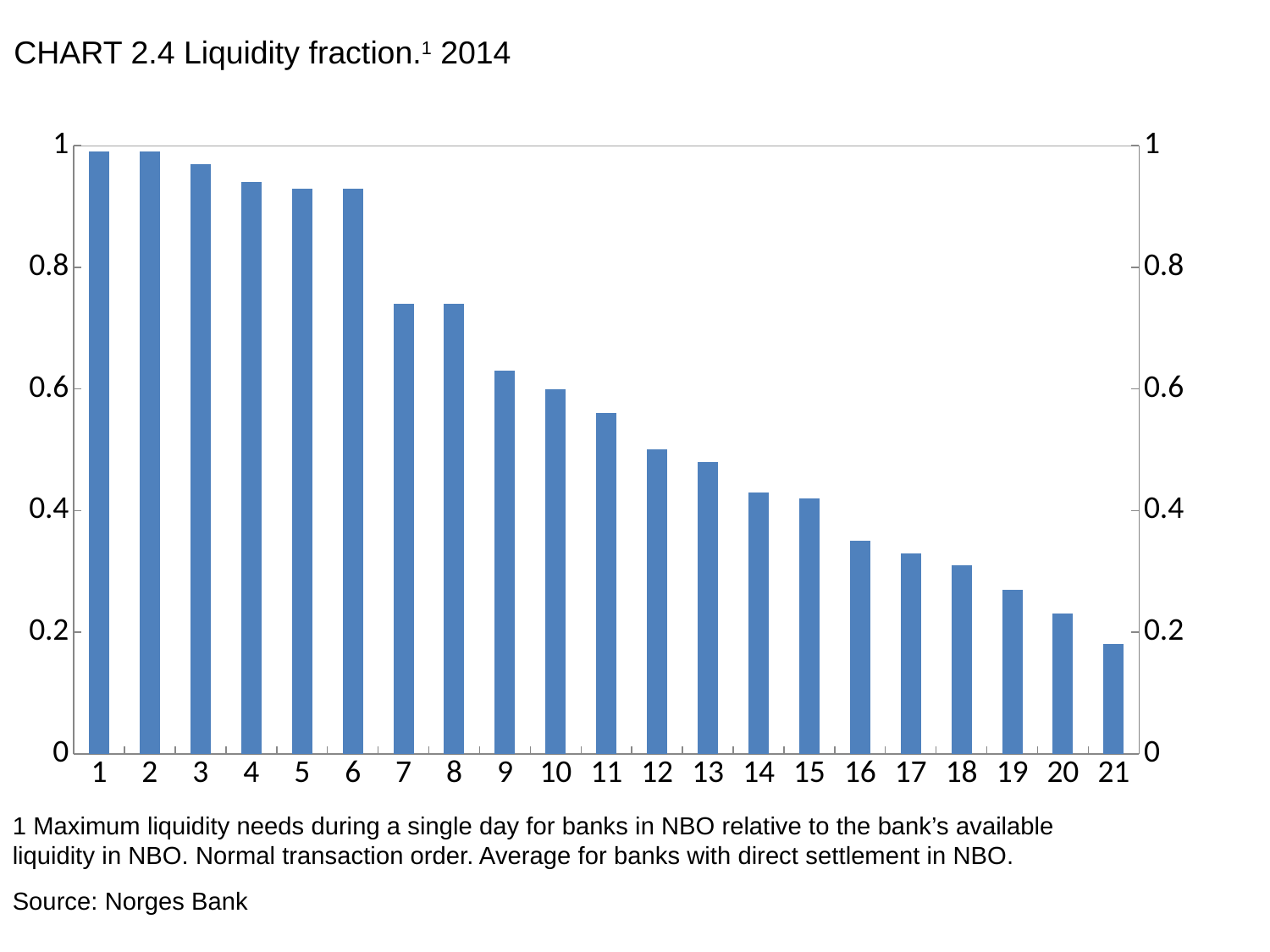
Is the value for category 21 greater or less than 0.2? less Is the value for category 16 greater or less than 0.4? less Do the values rise or fall as you move from category 1 to category 21 along the x axis? fall What kind of chart is shown on the slide? bar chart How many bars (categories) are plotted in the chart? 21 Is the value for category 7 greater or less than 0.6? greater Which category has the lowest liquidity fraction? 21 Which has the larger value, category 7 or category 9? 7 Which has the larger value, category 13 or category 18? 13 What is the title of the chart? CHART 2.4 Liquidity fraction. 2014